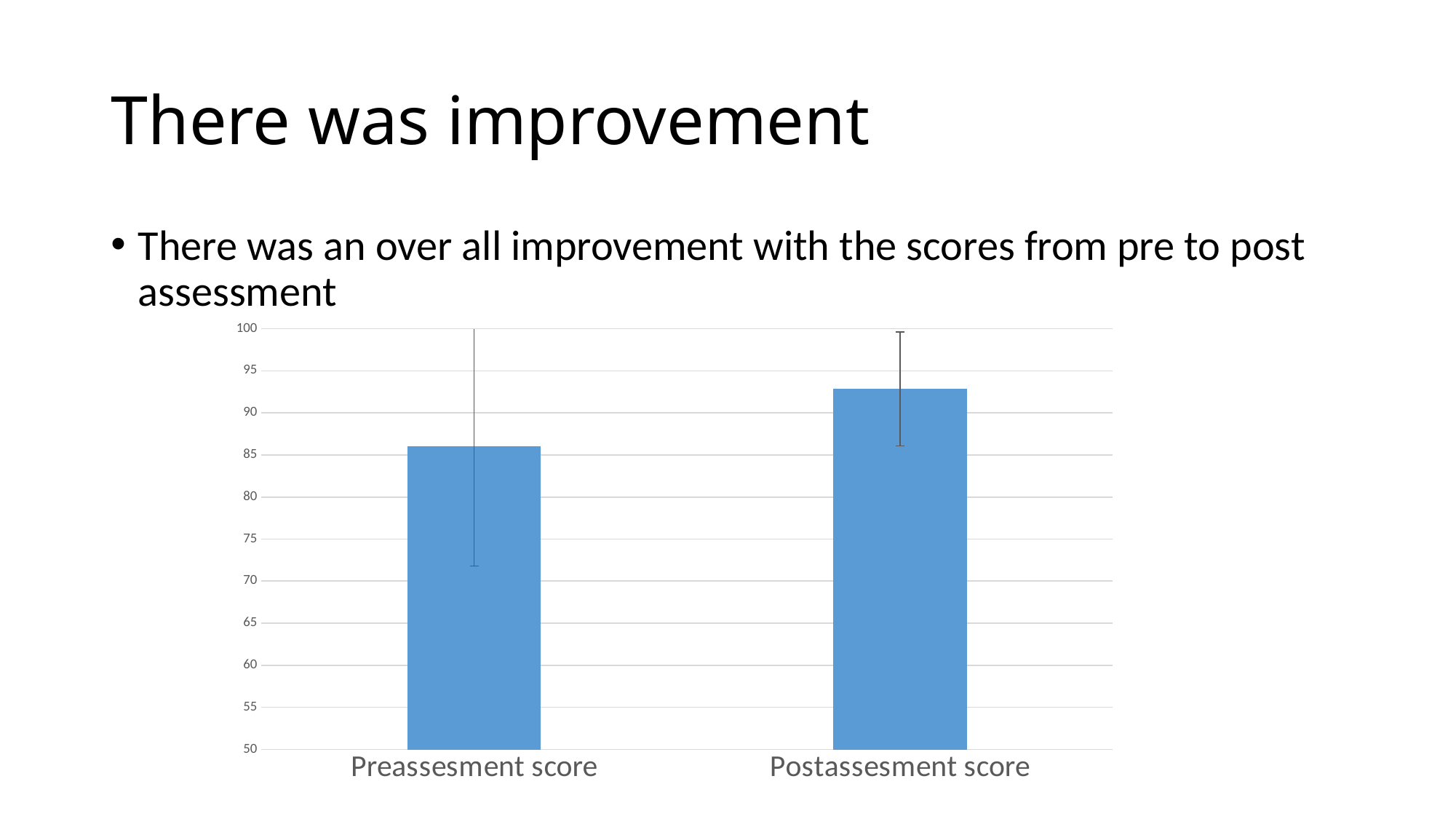
Is the value for Postassesment score greater or less than 95? less What kind of chart is shown on the slide? bar chart How many categories are plotted on the chart? 2 Which category has the lowest value on the chart? Preassesment score Is the value for Preassesment score greater or less than 80? greater What colour are the bars in the chart? blue What is the lowest value shown on the vertical axis of the chart? 50 Which category has the highest value on the chart? Postassesment score Is the value for Postassesment score greater or less than 90? greater Which is larger, the Preassesment score or the Postassesment score? Postassesment score Do the values rise or fall from Preassesment score to Postassesment score? rise